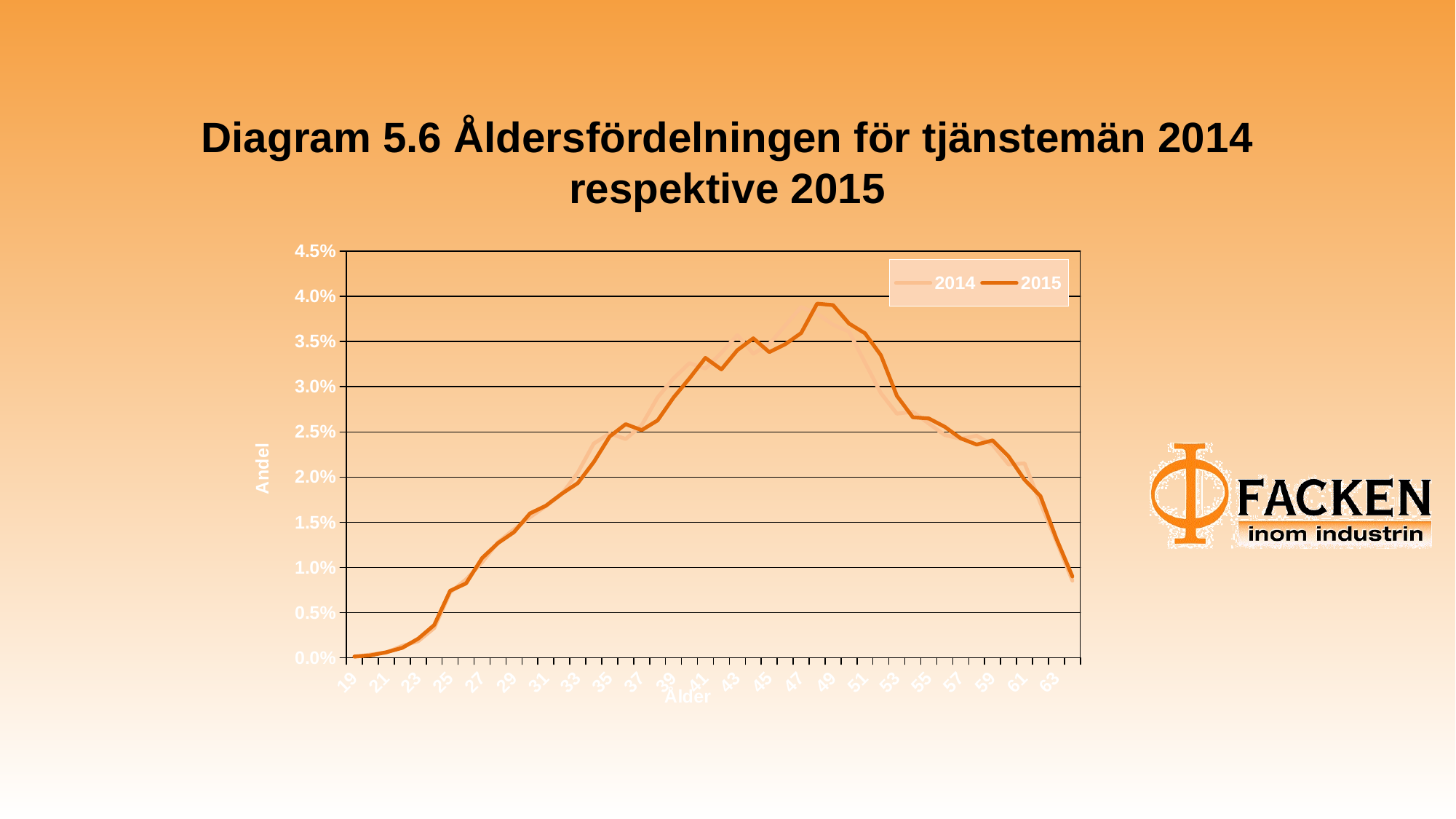
Is the value for the 2015 series at age 19 greater or less than 0.5%? less What is the label of the y axis? Andel What kind of chart is shown on the slide? line chart How many series does the legend list? 2 Is the value for the 2015 series at age 41 greater or less than 3.0%? greater Which two series are listed in the legend? 2014 and 2015 Does the 2015 series rise or fall between age 51 and age 63? fall Is the value for the 2015 series at age 49 greater or less than 3.5%? greater Does the 2015 series rise or fall between age 19 and age 49? rise